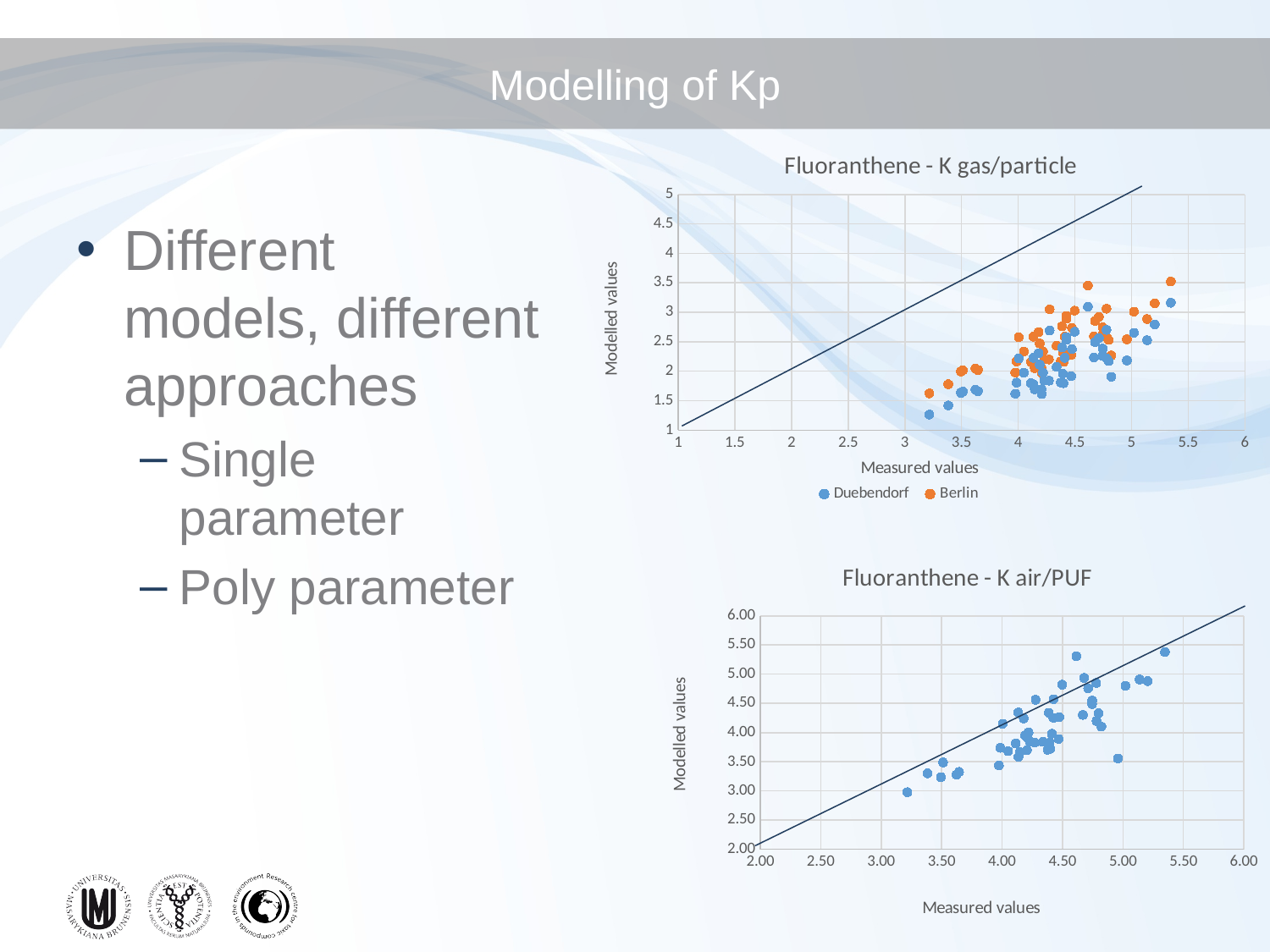
In the top chart "Fluoranthene - K gas/particle", is the highest modelled value for Berlin greater or less than 4? less How many series does the legend of the top chart "Fluoranthene - K gas/particle" list? 2 What kind of chart is the bottom chart titled "Fluoranthene - K air/PUF"? Scatter chart What is the x-axis title of the bottom chart "Fluoranthene - K air/PUF"? Measured values In the bottom chart "Fluoranthene - K air/PUF", is the lowest modelled value greater or less than 2.50? greater In the top chart "Fluoranthene - K gas/particle", do the modelled values generally rise or fall as the measured values increase? rise In the bottom chart "Fluoranthene - K air/PUF", is the highest modelled value greater or less than 5.00? greater Which series are listed in the legend of the top chart "Fluoranthene - K gas/particle"? Duebendorf and Berlin What kind of chart is the top chart titled "Fluoranthene - K gas/particle"? Scatter chart In the bottom chart "Fluoranthene - K air/PUF", do the modelled values generally rise or fall as the measured values increase? rise